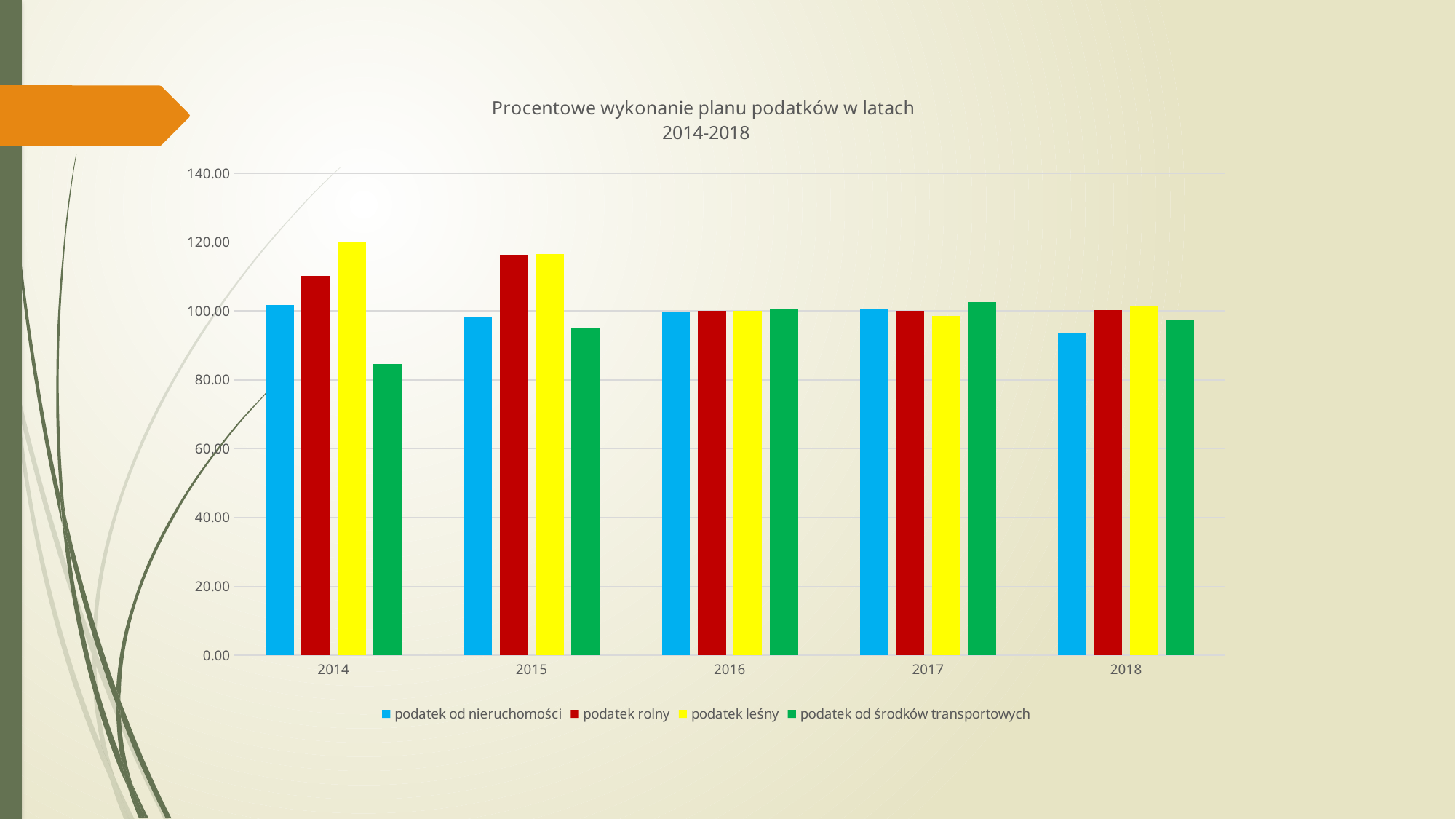
In 2015, which is larger: podatek rolny or podatek od środków transportowych? podatek rolny Is the value for podatek od nieruchomości in 2018 greater or less than 100.00? less What is the title of the chart? Procentowe wykonanie planu podatków w latach 2014-2018 Is the value for podatek rolny in 2015 greater or less than 100.00? greater What kind of chart is shown on the slide? bar chart Is the value for podatek od środków transportowych in 2014 greater or less than 100.00? less In 2014, which series has the lowest value? podatek od środków transportowych How many years are shown on the x axis? 5 What colour represents podatek rolny in the legend? red How many series does the legend list? 4 In 2014, which series has the highest value? podatek leśny